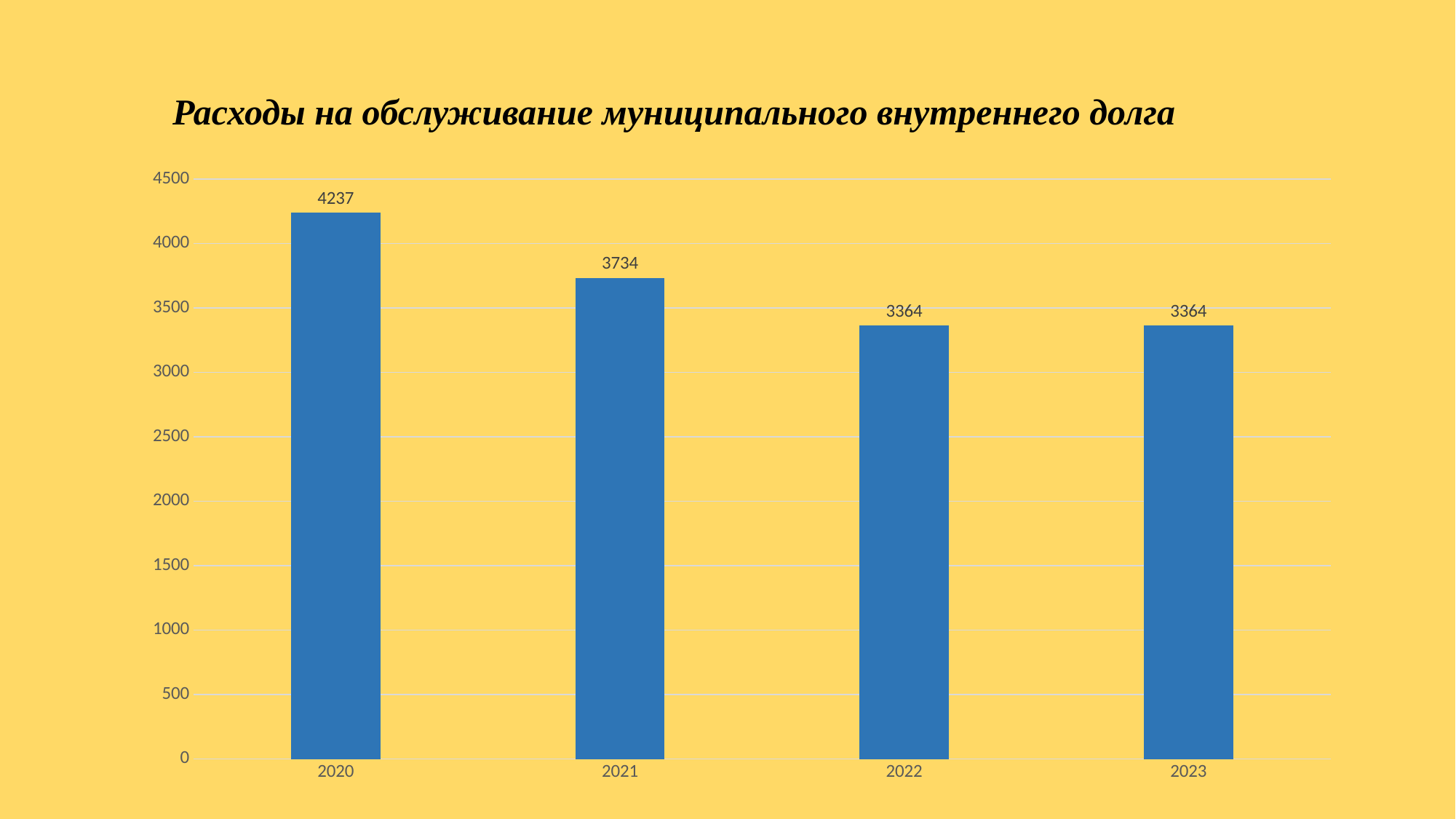
What is the value for 2021? 3734 What is the value for 2022? 3364 What is the value for 2020? 4237 Is the value for 2021 greater or less than 3500? greater Do the values rise or fall from 2020 to 2022? fall What is the difference between the values for 2020 and 2021? 503 What is the difference between the values for 2021 and 2023? 370 What is the title of the chart? Расходы на обслуживание муниципального внутреннего долга Which year has the highest value? 2020 Which is larger, the value for 2020 or the value for 2022? 2020 What kind of chart is this? bar chart How many years are shown on the x axis? 4